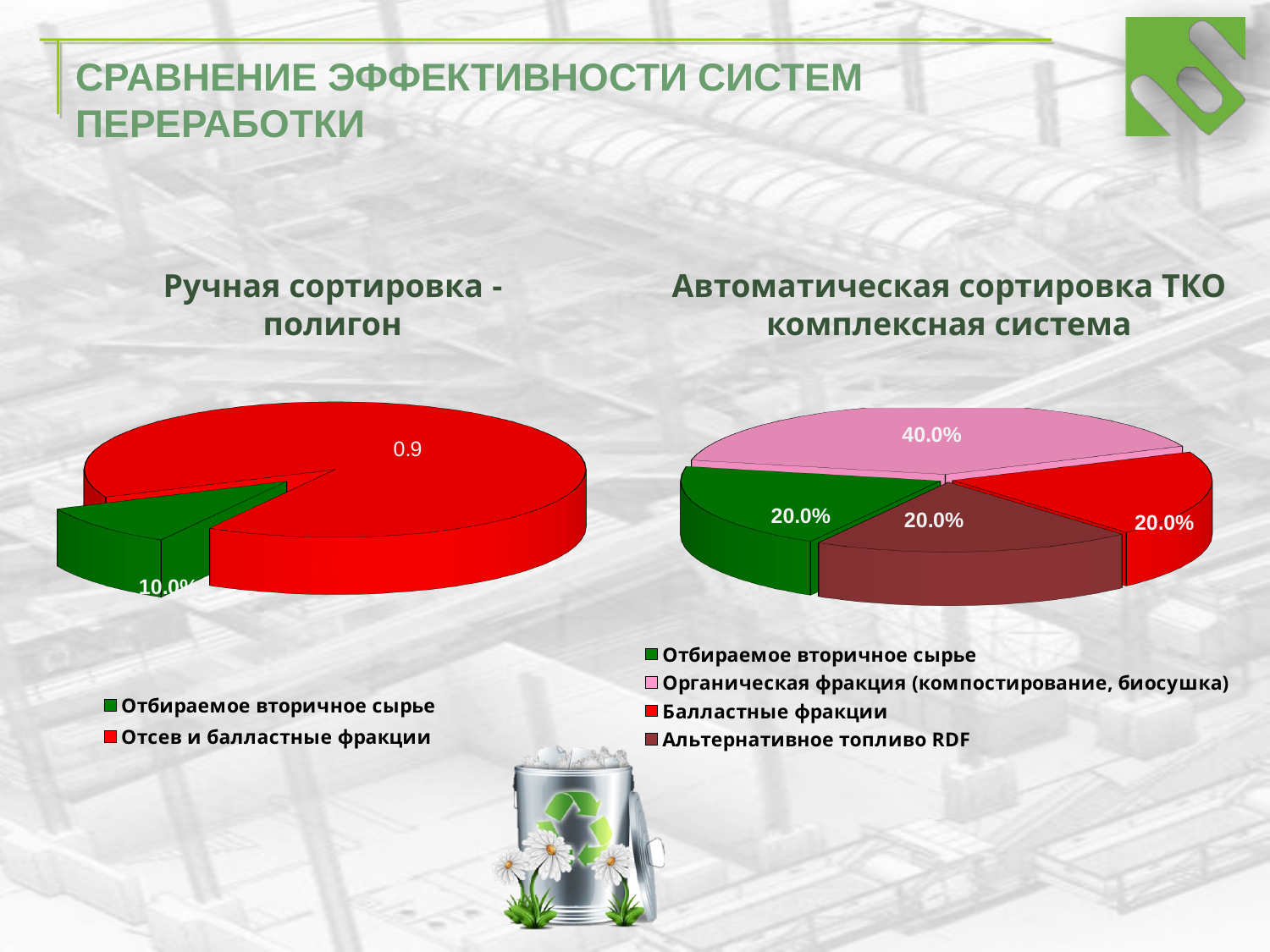
How many entries does the legend of the right chart "Автоматическая сортировка ТКО комплексная система" list? 4 In the right chart "Автоматическая сортировка ТКО комплексная система", which category has the largest slice? Органическая фракция (компостирование, биосушка) In the right chart "Автоматическая сортировка ТКО комплексная система", what share is shown for Альтернативное топливо RDF? 20.0% What kind of chart is the left chart titled "Ручная сортировка - полигон"? pie chart In the left chart "Ручная сортировка - полигон", what data label is printed on the red slice for Отсев и балластные фракции? 0.9 How many entries does the legend of the left chart "Ручная сортировка - полигон" list? 2 In the right chart "Автоматическая сортировка ТКО комплексная система", how much larger is the share of Органическая фракция (компостирование, биосушка) than that of Отбираемое вторичное сырье? 20.0 percentage points In the right chart "Автоматическая сортировка ТКО комплексная система", what share is shown for Балластные фракции? 20.0% In the right chart "Автоматическая сортировка ТКО комплексная система", what share is shown for Органическая фракция (компостирование, биосушка)? 40.0% In the left chart "Ручная сортировка - полигон", which slice is larger: Отбираемое вторичное сырье or Отсев и балластные фракции? Отсев и балластные фракции In the right chart "Автоматическая сортировка ТКО комплексная система", what colour is the slice for Органическая фракция (компостирование, биосушка)? pink How many slices does the right chart "Автоматическая сортировка ТКО комплексная система" have? 4